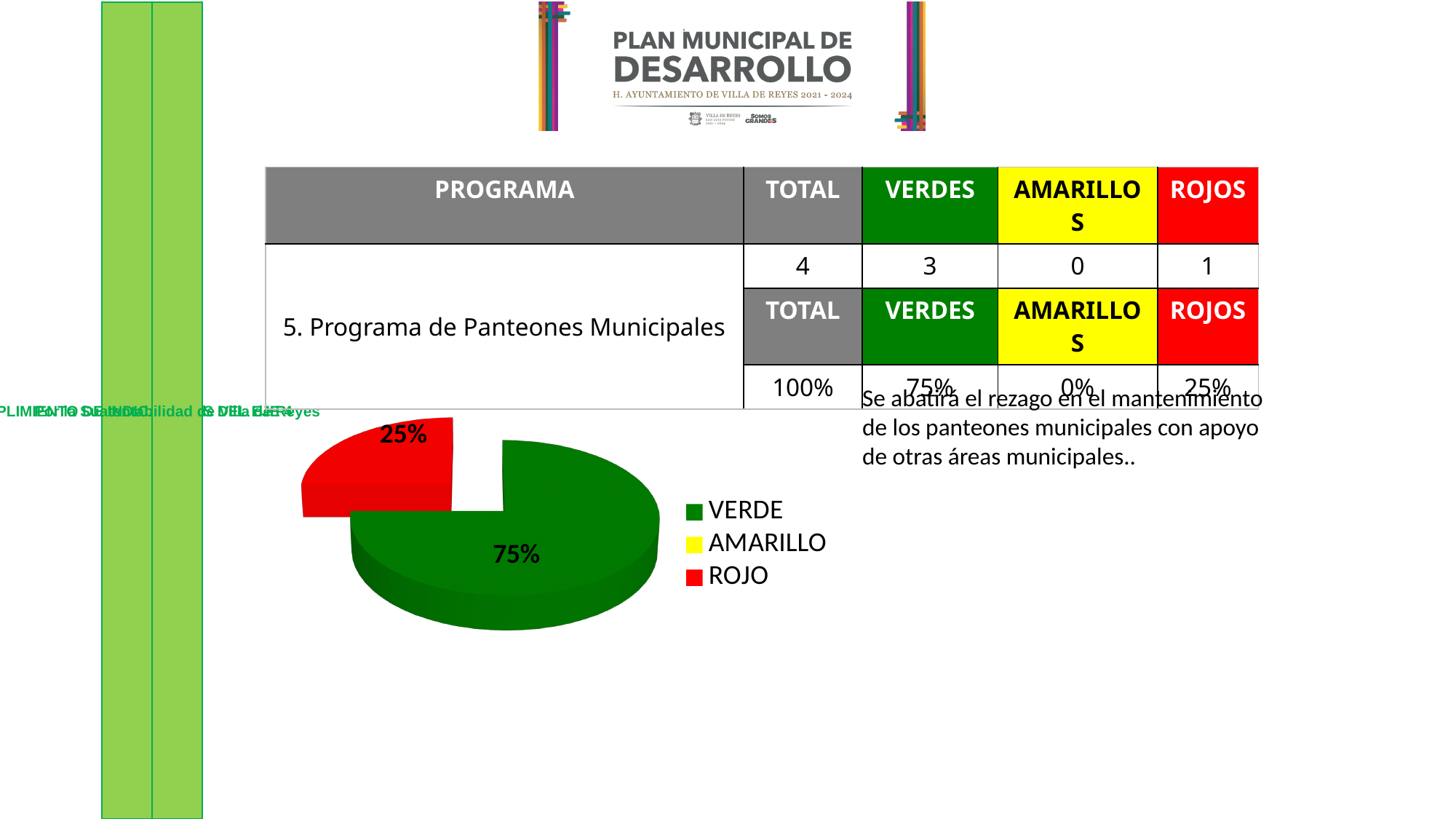
What kind of chart is shown on the slide? pie chart What is the difference in percentage points between the VERDE and ROJO slices? 50% How many entries does the legend of the pie chart list? 3 Which of the two labelled slices is larger, VERDE or ROJO? VERDE What colour is the VERDE slice in the pie chart? green What share of the pie does the ROJO slice represent? 25% What share of the pie does the VERDE slice represent? 75% Which legend entry is shown in red? ROJO How many slices of the pie have a data label printed on them? 2 Which category has the largest slice of the pie? VERDE Is the share of the ROJO slice greater or less than 50%? less